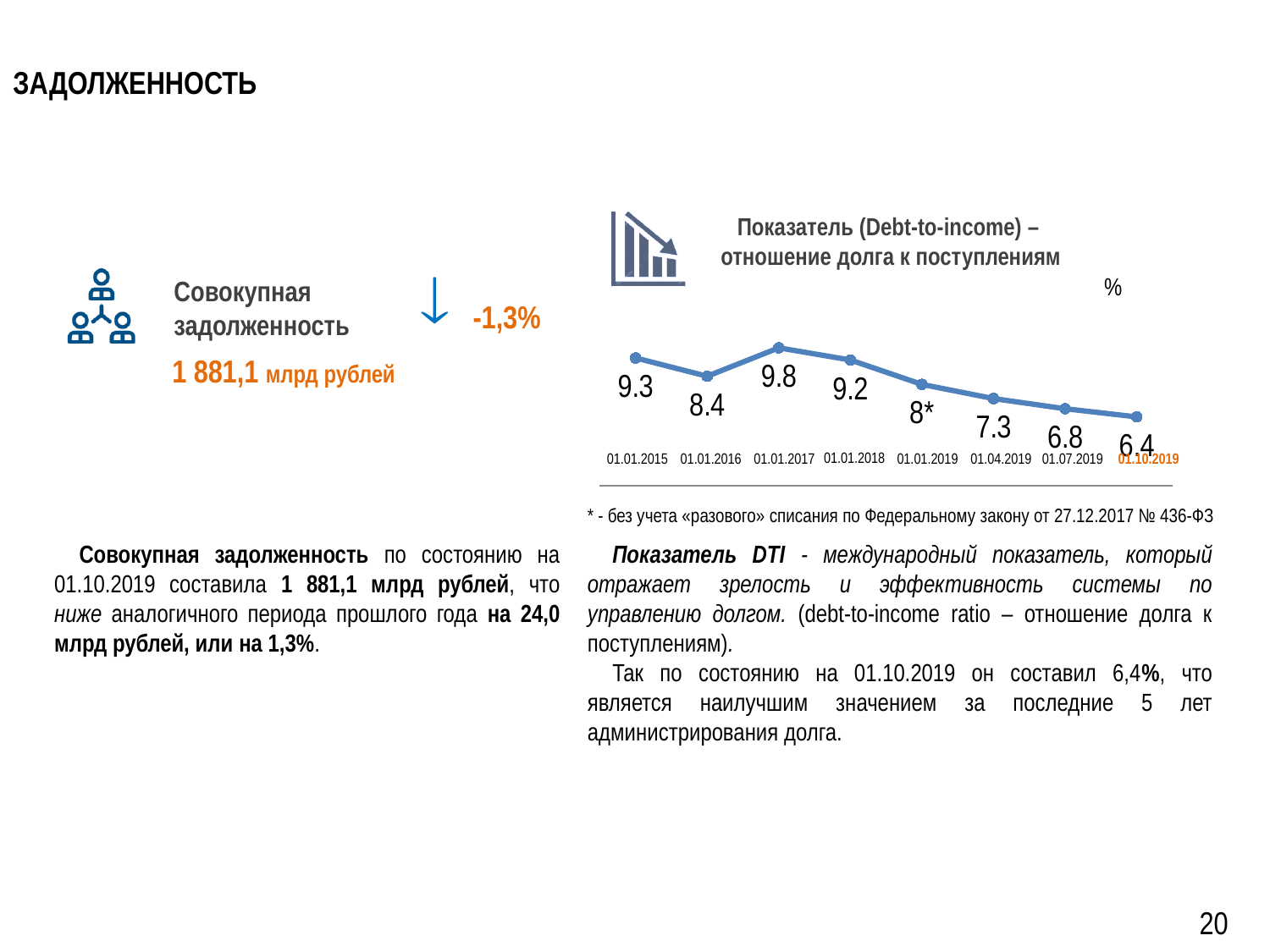
What is the DTI value for 01.01.2017? 9.8 What is the difference between the DTI values for 01.01.2017 and 01.01.2016? 1.4 Which is larger, the DTI value for 01.01.2018 or for 01.07.2019? 01.01.2018 What is the DTI value for 01.10.2019? 6.4 Which date has the lowest DTI value? 01.10.2019 What is the DTI value for 01.01.2015? 9.3 What is the DTI value for 01.04.2019? 7.3 Does the DTI value rise or fall from 01.01.2018 to 01.10.2019? fall Which date has the highest DTI value? 01.01.2017 What unit is indicated for the values on the chart? % What type of chart is shown on the slide? line chart How many data points are plotted on the chart? 8